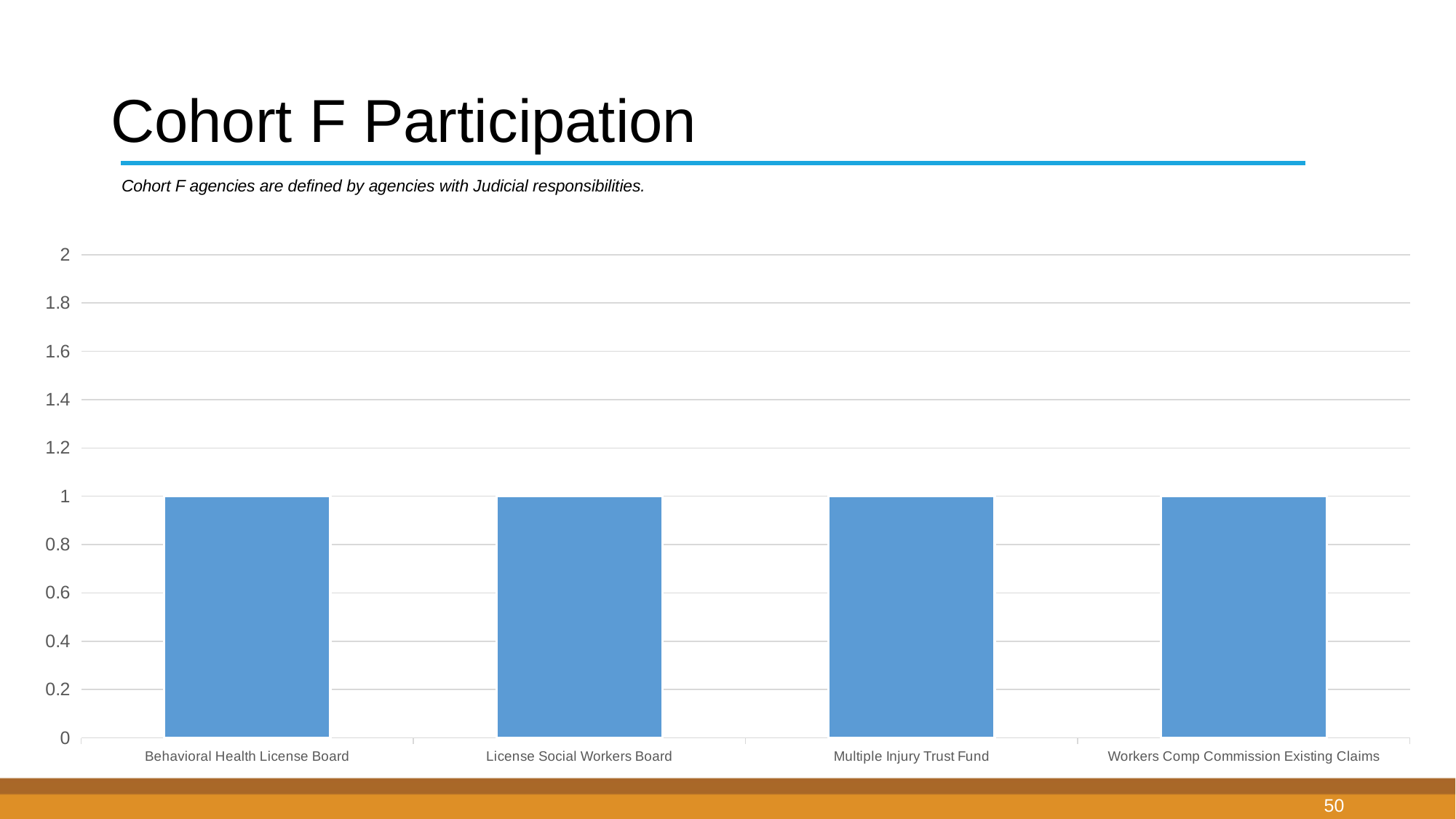
Is the value for Workers Comp Commission Existing Claims greater or less than 1.2? less What colour are the bars in the chart? Blue What is the value for Behavioral Health License Board? 1 What is the difference between the values for Behavioral Health License Board and License Social Workers Board? 0 Is the value for Multiple Injury Trust Fund greater or less than 0.8? greater What is the title of the chart on the slide? Cohort F Participation How many agencies (categories) are shown on the x axis? 4 What is the value for Workers Comp Commission Existing Claims? 1 What is the value for Multiple Injury Trust Fund? 1 Do the values rise, fall, or stay the same across the categories from left to right? Stay the same What is the value for License Social Workers Board? 1 What type of chart is shown on the slide? Bar chart